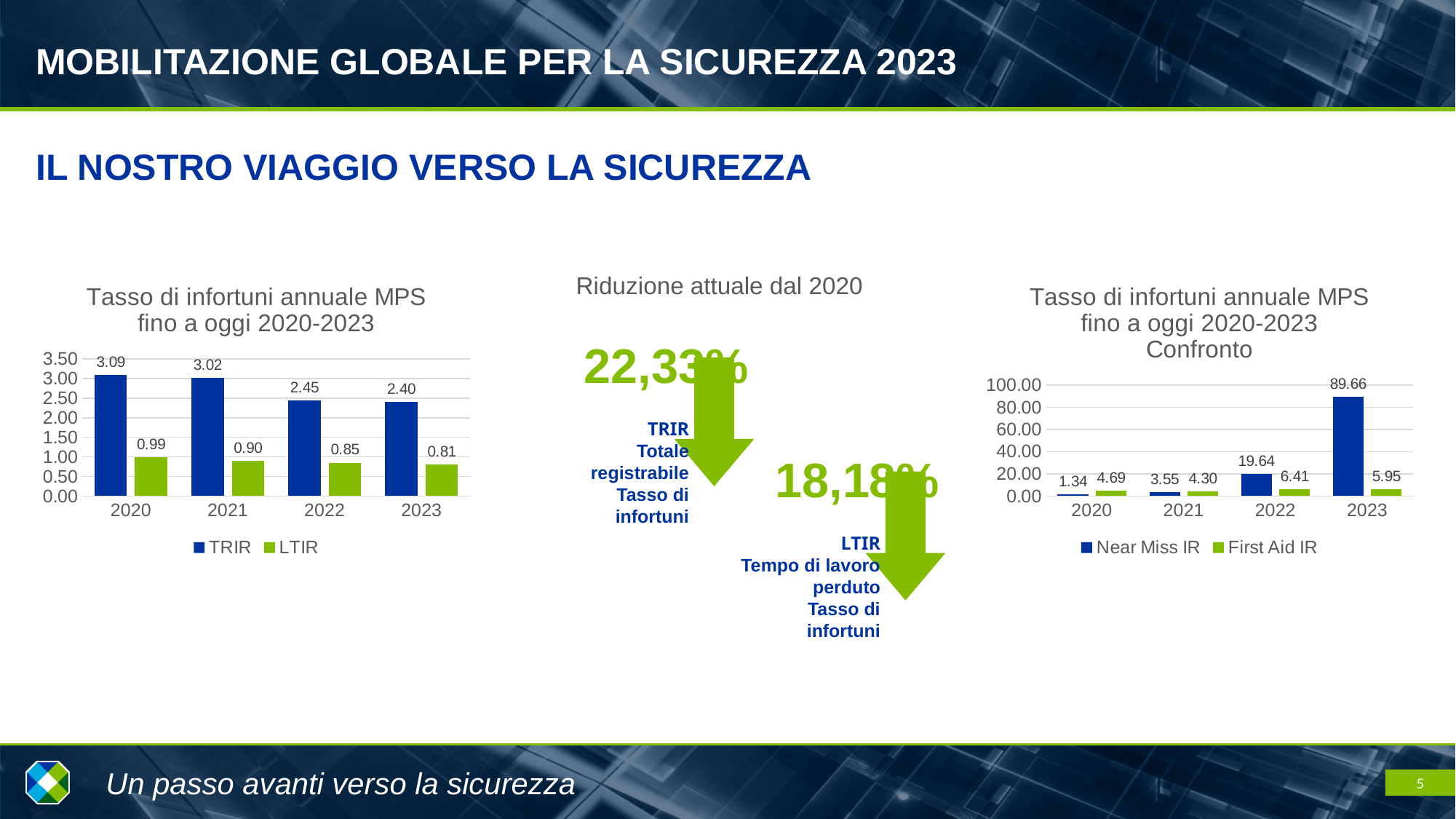
In the left chart (Tasso di infortuni annuale MPS fino a oggi 2020-2023), how many series does the legend list? 2 In the left chart (Tasso di infortuni annuale MPS fino a oggi 2020-2023), does the TRIR series rise or fall from 2020 to 2023? fall In the right chart (Tasso di infortuni annuale MPS fino a oggi 2020-2023 Confronto), how many years are shown on the x axis? 4 In the right chart (Tasso di infortuni annuale MPS fino a oggi 2020-2023 Confronto), what is the Near Miss IR value for 2023? 89.66 In the left chart (Tasso di infortuni annuale MPS fino a oggi 2020-2023), what is the difference between the TRIR values for 2020 and 2023? 0.69 In the left chart (Tasso di infortuni annuale MPS fino a oggi 2020-2023), which year has the lowest TRIR value? 2023 What type of chart is the right chart (Tasso di infortuni annuale MPS fino a oggi 2020-2023 Confronto)? bar chart In the left chart (Tasso di infortuni annuale MPS fino a oggi 2020-2023), what is the TRIR value for 2020? 3.09 In the left chart (Tasso di infortuni annuale MPS fino a oggi 2020-2023), what is the LTIR value for 2023? 0.81 In the right chart (Tasso di infortuni annuale MPS fino a oggi 2020-2023 Confronto), which year has the highest Near Miss IR value? 2023 In the right chart (Tasso di infortuni annuale MPS fino a oggi 2020-2023 Confronto), what is the First Aid IR value for 2022? 6.41 In the right chart (Tasso di infortuni annuale MPS fino a oggi 2020-2023 Confronto), which is larger in 2021: Near Miss IR or First Aid IR? First Aid IR